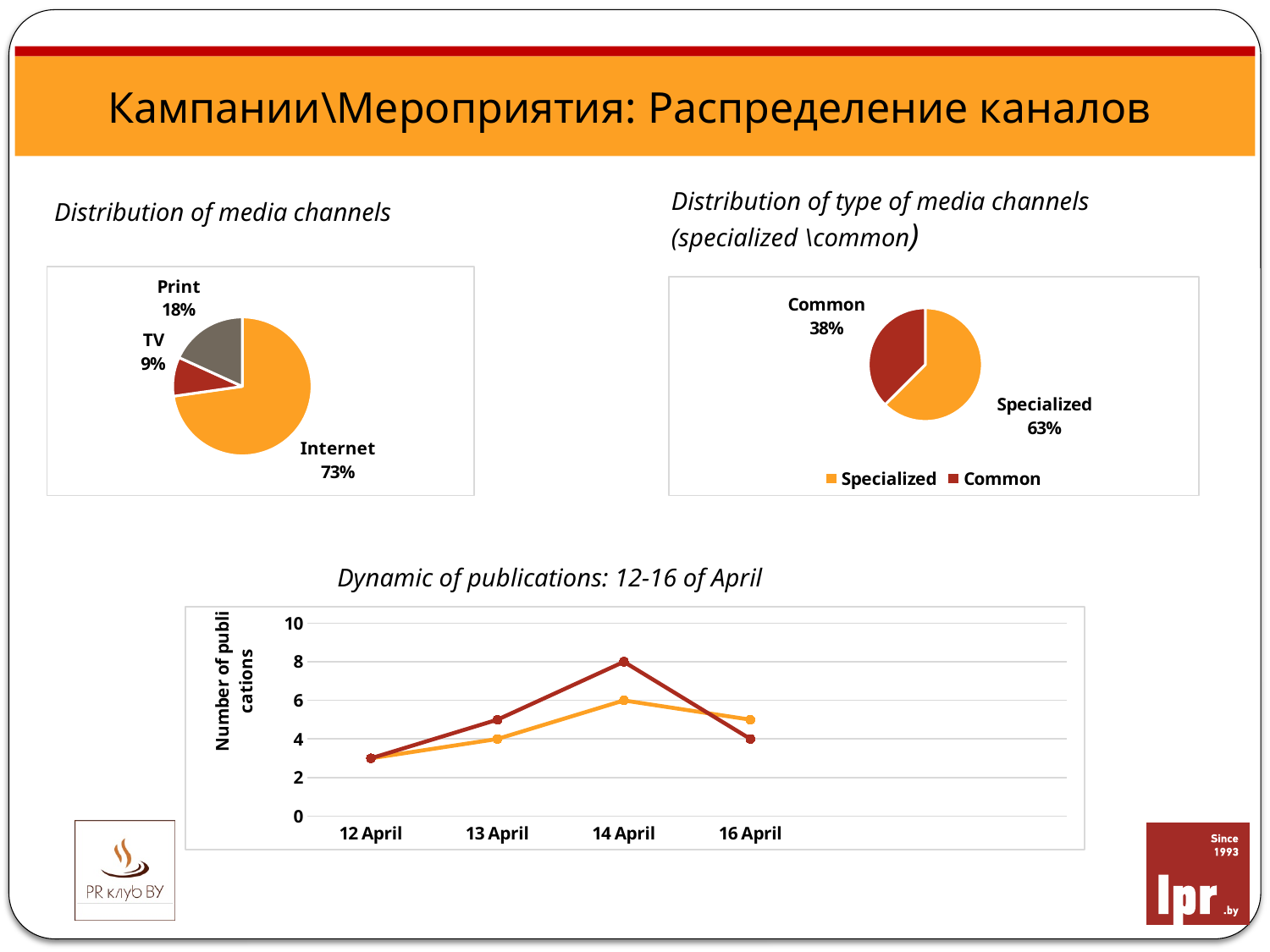
In the 'Distribution of media channels' pie chart, what share does Internet have? 73% In the 'Distribution of media channels' pie chart, what share does TV have? 9% How many entries does the legend of the 'Distribution of type of media channels' pie chart list? 2 In the 'Dynamic of publications' chart, what is the value of the red line on 14 April? 8 In the 'Distribution of media channels' pie chart, what is the difference between the Print and TV shares? 9% In the 'Dynamic of publications' chart, how many dates are shown on the x axis? 4 In the 'Distribution of type of media channels' pie chart, what share is Specialized? 63% In the 'Distribution of media channels' pie chart, which category has the smallest share? TV In the 'Dynamic of publications' chart, is the value of the orange line on 16 April greater or less than 4? greater In the 'Dynamic of publications' chart, on which date does the red line reach its highest value? 14 April In the 'Distribution of type of media channels' pie chart, which is larger, Common or Specialized? Specialized What kind of chart is 'Dynamic of publications: 12-16 of April'? line chart